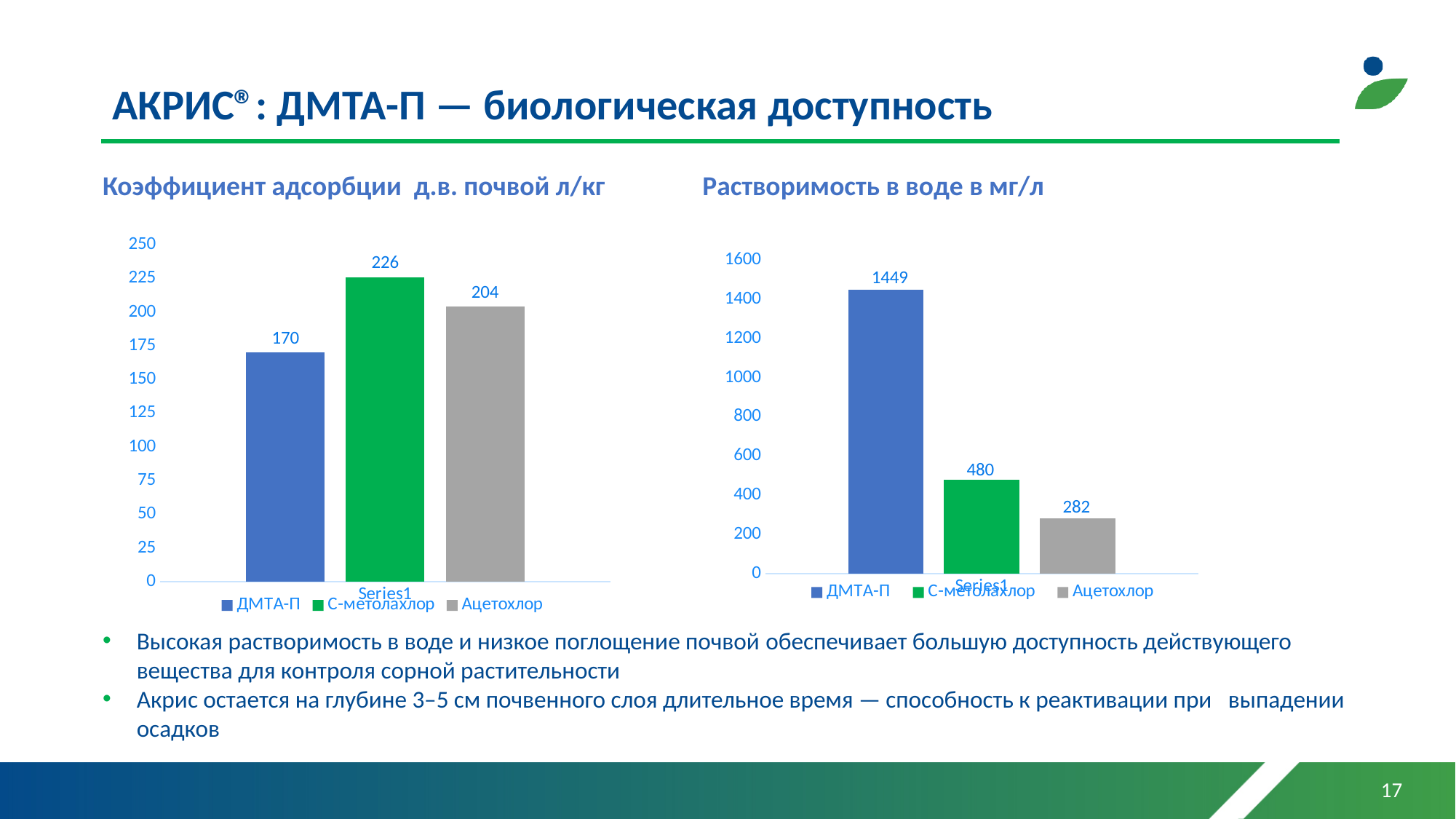
In the right chart (Растворимость в воде в мг/л), what is the value for ДМТА-П? 1449 In the right chart (Растворимость в воде в мг/л), which is larger, С-метолахлор or Ацетохлор? С-метолахлор In the left chart (Коэффициент адсорбции д.в. почвой л/кг), how many series does the legend list? 3 In the left chart (Коэффициент адсорбции д.в. почвой л/кг), what is the value for С-метолахлор? 226 In the left chart (Коэффициент адсорбции д.в. почвой л/кг), what is the difference between С-метолахлор and Ацетохлор? 22 In the right chart (Растворимость в воде в мг/л), what is the value for Ацетохлор? 282 In the left chart (Коэффициент адсорбции д.в. почвой л/кг), what is the value for ДМТА-П? 170 In the right chart (Растворимость в воде в мг/л), what is the difference between ДМТА-П and С-метолахлор? 969 In the left chart (Коэффициент адсорбции д.в. почвой л/кг), what colour is the bar for Ацетохлор? grey In the right chart (Растворимость в воде в мг/л), which series has the highest value? ДМТА-П In the left chart (Коэффициент адсорбции д.в. почвой л/кг), which series has the lowest value? ДМТА-П What kind of chart is the right chart (Растворимость в воде в мг/л)? bar chart